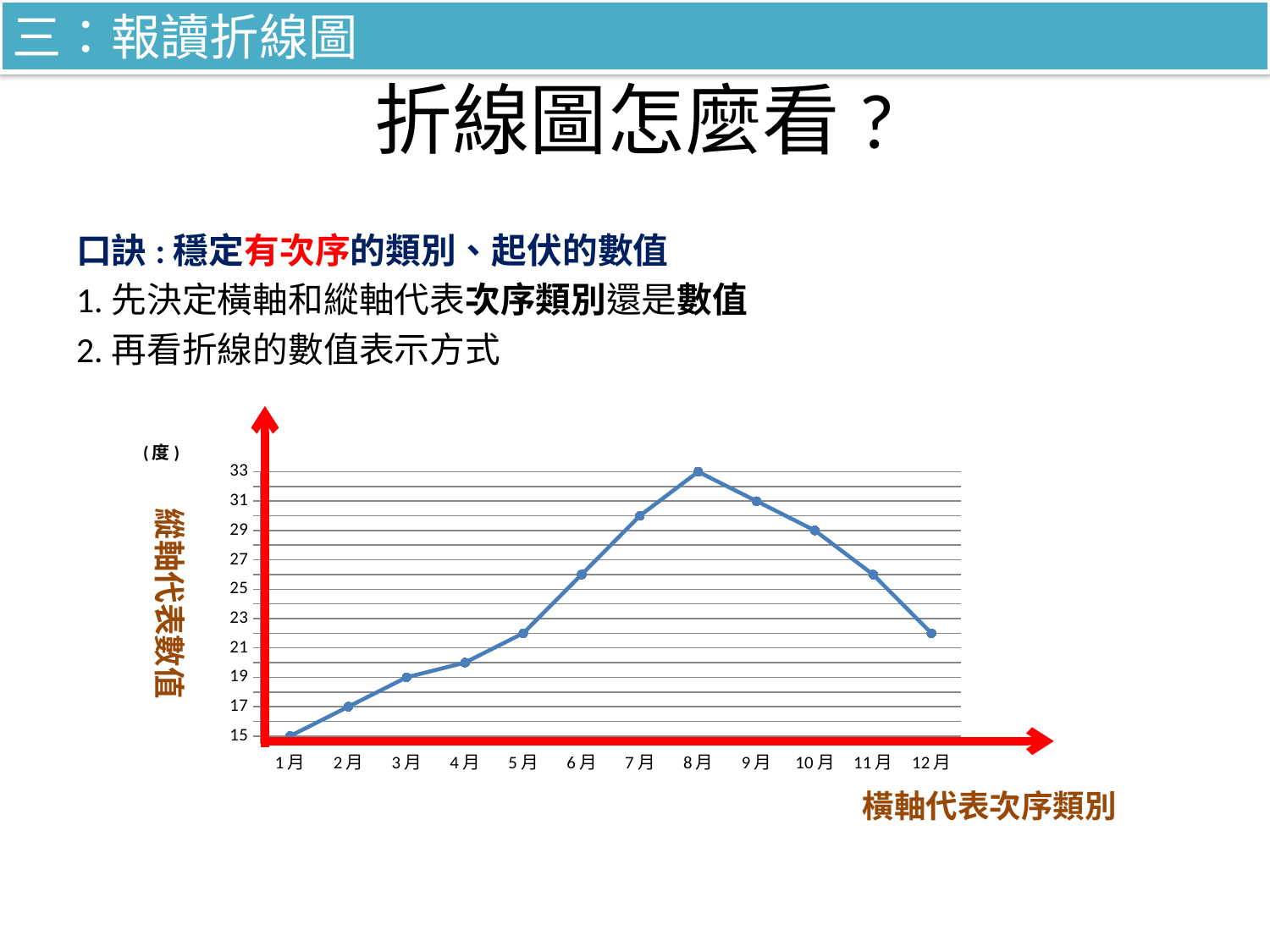
Is the value for 4月 greater or less than 21? less Which is larger, the value for 7月 or the value for 11月? 7月 What is the value for 1月 on the chart? 15 What is the value for 10月 on the chart? 29 What kind of chart is shown on the slide? line chart What unit is shown at the top of the vertical axis? (度) Which month has the highest value on the chart? 8月 What is the value for 8月 on the chart? 33 What is the difference between the values for 8月 and 1月? 18 How many months are plotted along the x axis of the chart? 12 Which month has the lowest value on the chart? 1月 Do the values rise or fall from 1月 to 8月? rise